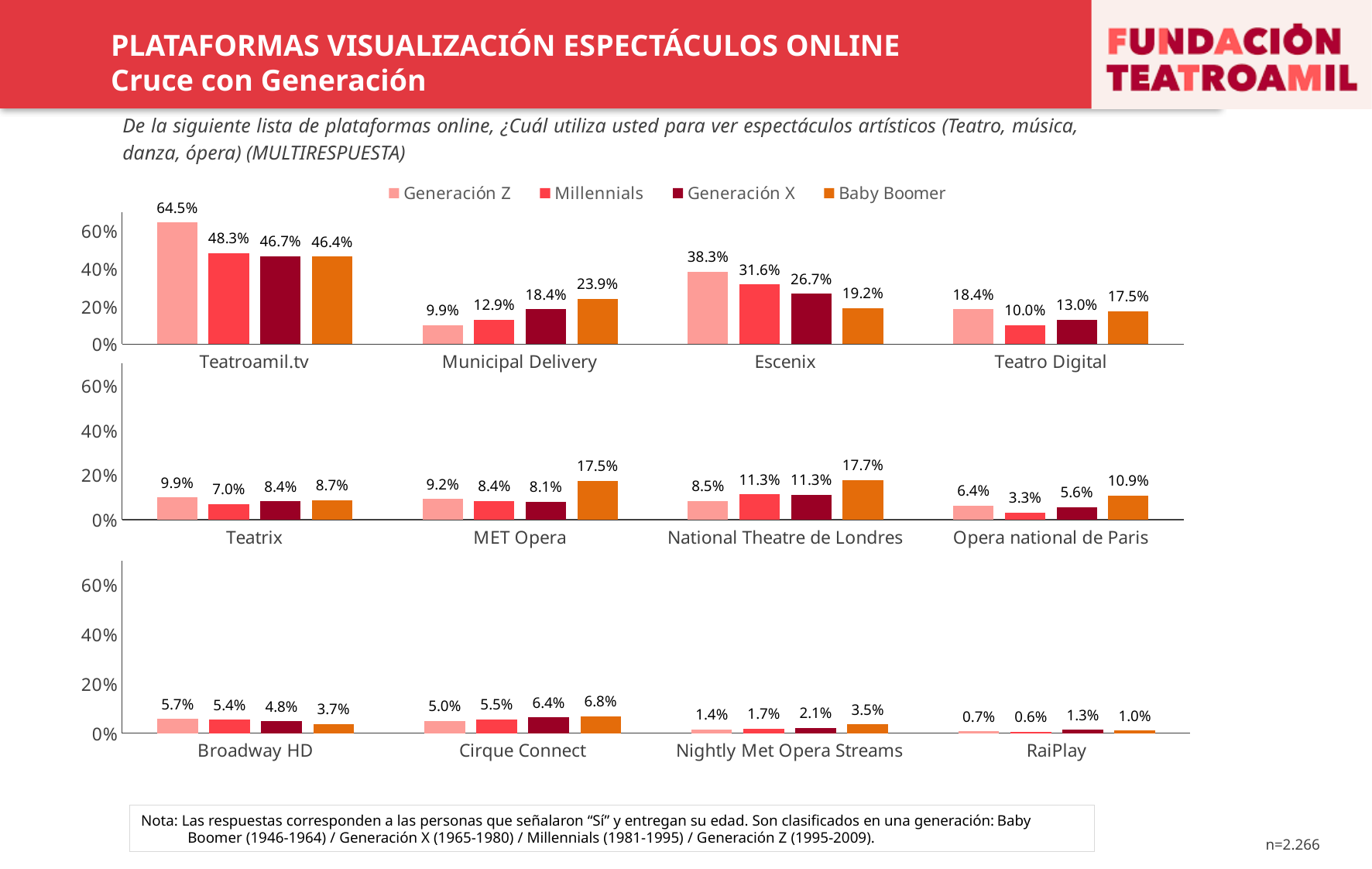
In the middle chart, what is the value for Millennials for Opera national de Paris? 3.3% In the bottom chart, which generation has the lowest value for RaiPlay? Millennials In the bottom chart, do the values for Nightly Met Opera Streams rise or fall from Generación Z to Baby Boomer? Rise In the top chart, what is the value for Baby Boomer for Municipal Delivery? 23.9% How many platform categories are shown in the bottom chart? 4 How many series does the legend on the slide list? 4 In the top chart, what is the value for Generación Z for Teatroamil.tv? 64.5% In the top chart, which generation has the highest value for Escenix? Generación Z In the top chart, what is the difference between the Generación Z and Millennials values for Teatroamil.tv? 16.2% In the middle chart, which is larger for Teatrix: the Generación Z value or the Baby Boomer value? Generación Z In the bottom chart, what is the value for Generación X for Cirque Connect? 6.4% What kind of chart is the middle chart? Bar chart